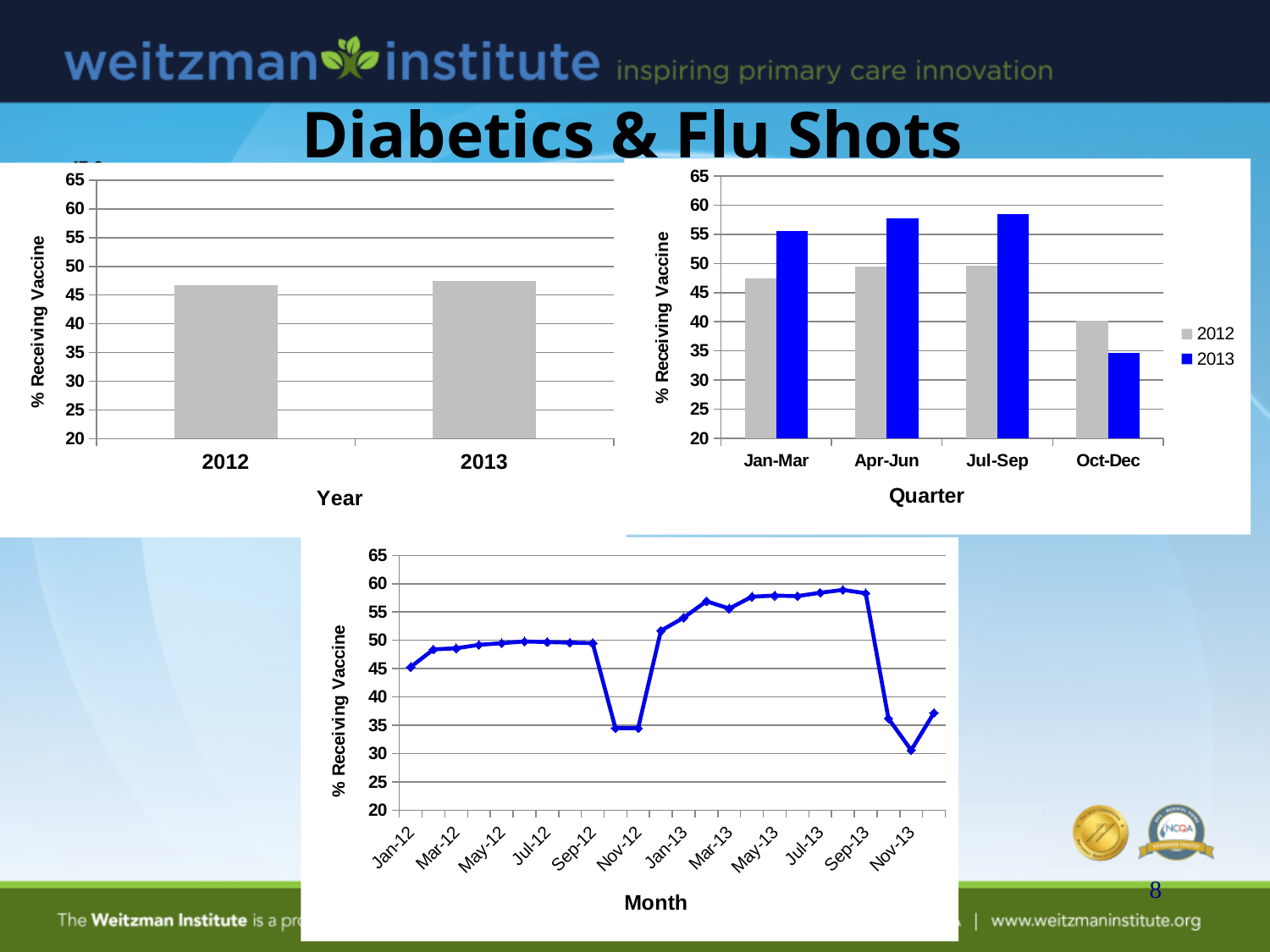
In the top-right chart (by Quarter), is the 2013 value for Oct-Dec greater or less than 40? less In the top-right chart (by Quarter), how many series does the legend list? 2 In the top-right chart (by Quarter), which is larger for Jan-Mar, the 2012 value or the 2013 value? 2013 What kind of chart is the bottom chart with the x axis labelled Month? line chart In the top-left chart (by Year), is the value for 2013 greater or less than 45? greater In the top-right chart (by Quarter), which is larger for Oct-Dec, the 2012 value or the 2013 value? 2012 In the top-left chart (by Year), is the value for 2012 greater or less than 50? less What kind of chart is the top-left chart with the x axis labelled Year? bar chart In the top-right chart (by Quarter), which quarter has the lowest value for 2013? Oct-Dec In the bottom chart (by Month), which month has the lowest value? Nov-13 In the top-left chart (by Year), how many years are shown on the x axis? 2 In the bottom chart (by Month), what is the y-axis title? % Receiving Vaccine